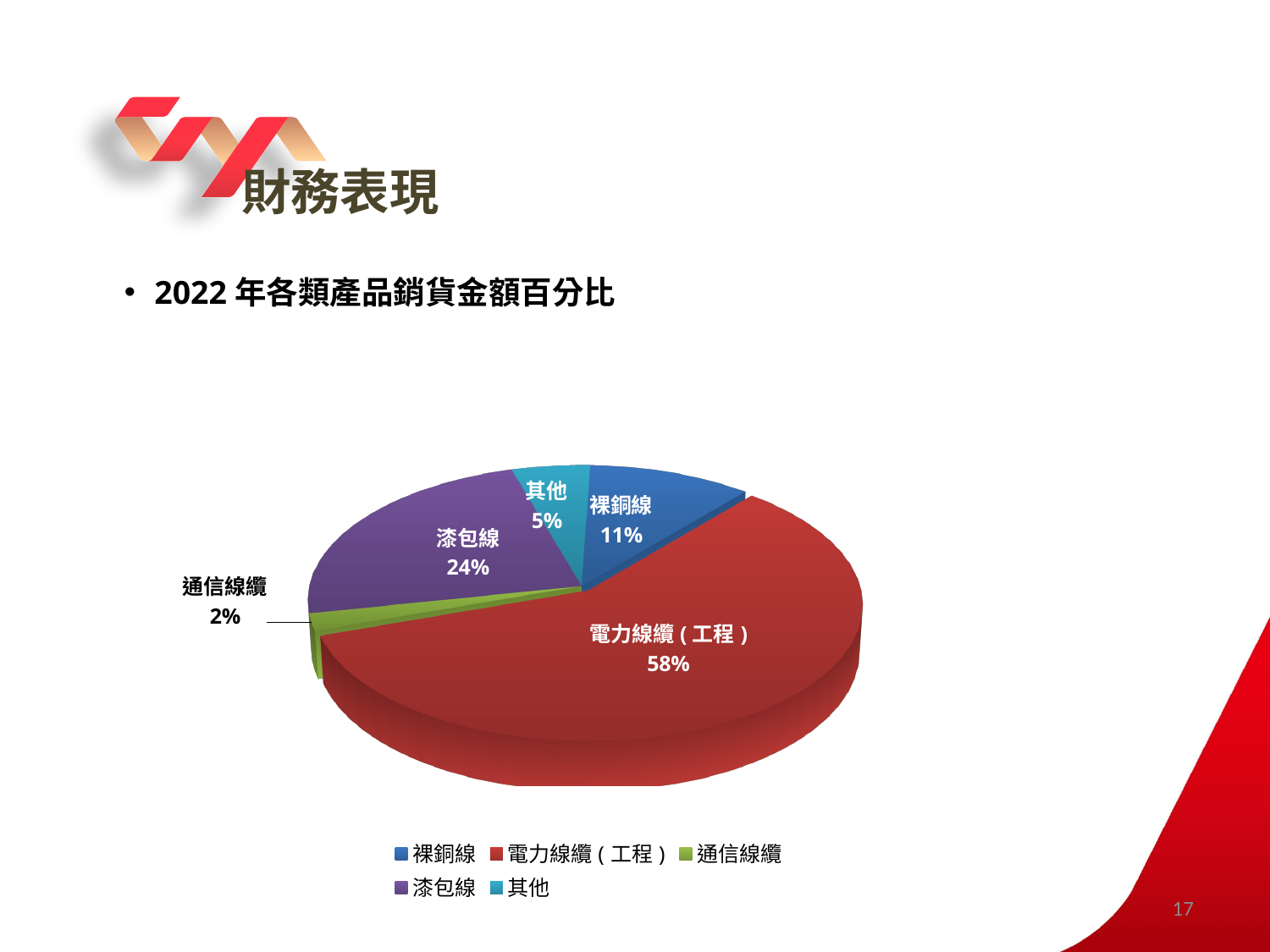
What is the difference in percentage points between the shares of 電力線纜（工程） and 漆包線? 34 What percentage of 2022 sales is attributed to 通信線纜? 2% Which has a larger share of 2022 sales, 裸銅線 or 其他? 裸銅線 What type of chart is shown on the slide? Pie chart What percentage of 2022 sales is attributed to 電力線纜（工程）? 58% What percentage of 2022 sales is attributed to 裸銅線? 11% What percentage of 2022 sales is attributed to 漆包線? 24% What colour represents 漆包線 in the pie chart? Purple Which product category has the smallest share of 2022 sales? 通信線纜 What percentage of 2022 sales is attributed to 其他? 5% Which product category has the largest share of 2022 sales? 電力線纜（工程） How many product categories are shown in the pie chart? 5